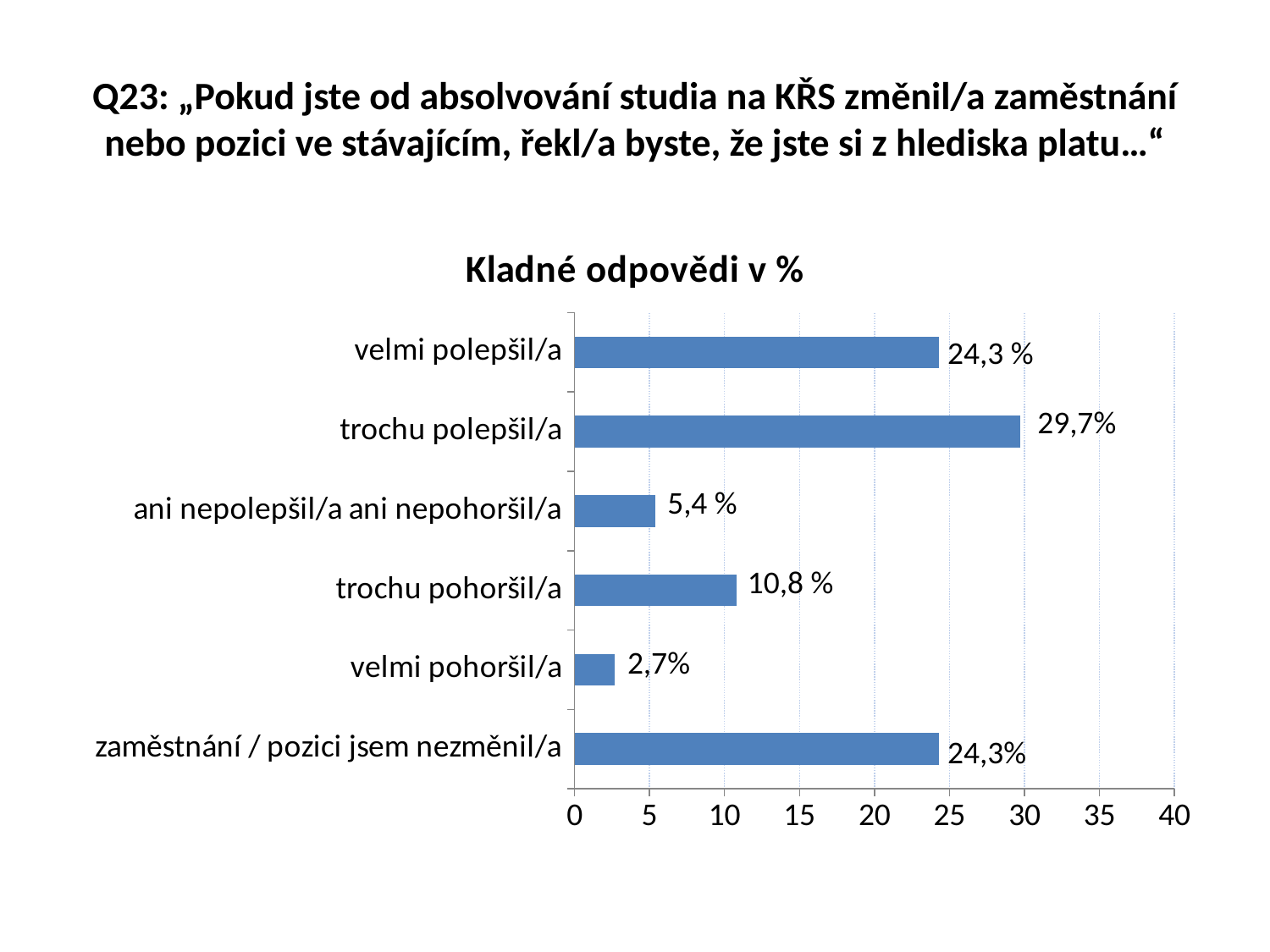
What is the difference between the values for "velmi polepšil/a" and "velmi pohoršil/a"? 21,6 % Is the value for "trochu polepšil/a" greater or less than 25? greater What is the value for "velmi pohoršil/a"? 2,7% What type of chart is shown on the slide? bar chart How many categories are shown in the chart? 6 Which category has the lowest value? velmi pohoršil/a What is the value for "trochu pohoršil/a"? 10,8 % What is the value for "trochu polepšil/a"? 29,7% Which category has the highest value? trochu polepšil/a What is the value for "ani nepolepšil/a ani nepohoršil/a"? 5,4 % Which is larger, the value for "trochu pohoršil/a" or for "ani nepolepšil/a ani nepohoršil/a"? trochu pohoršil/a What is the difference between the values for "trochu polepšil/a" and "velmi polepšil/a"? 5,4 %